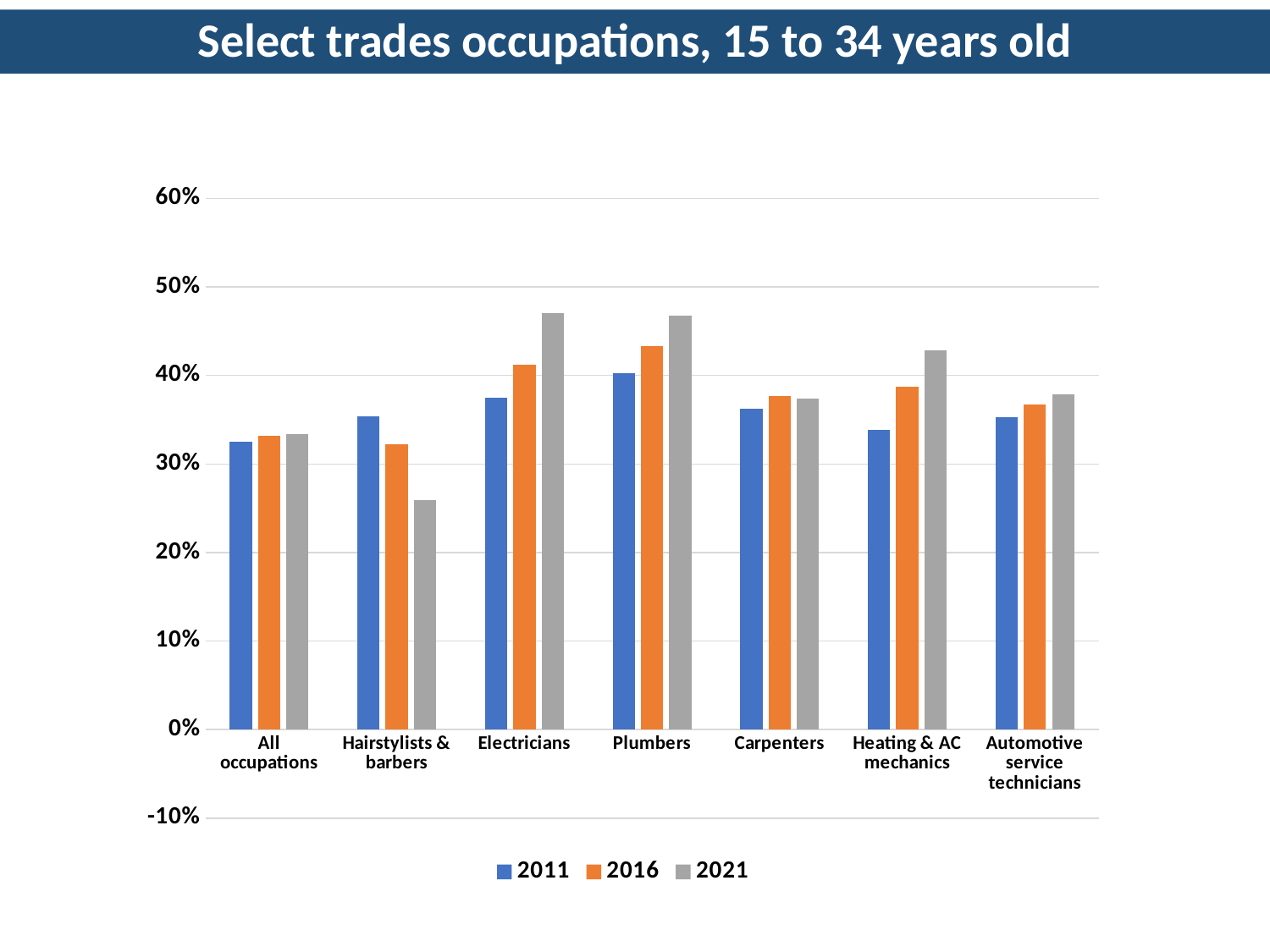
How many occupation categories are shown on the x axis? 7 How many series does the legend list? 3 Which occupation has the lowest value for 2021? Hairstylists & barbers Is the 2021 value for Heating & AC mechanics greater or less than 40%? greater Is the 2021 value for Carpenters greater or less than 40%? less Do the values for Electricians rise or fall from 2011 to 2021? rise Is the 2021 value for Electricians greater or less than 40%? greater What kind of chart is shown on the slide? bar chart For Hairstylists & barbers, which is larger: the 2011 value or the 2021 value? 2011 Which occupation has the highest value for 2011? Plumbers Which years are listed in the legend? 2011, 2016, 2021